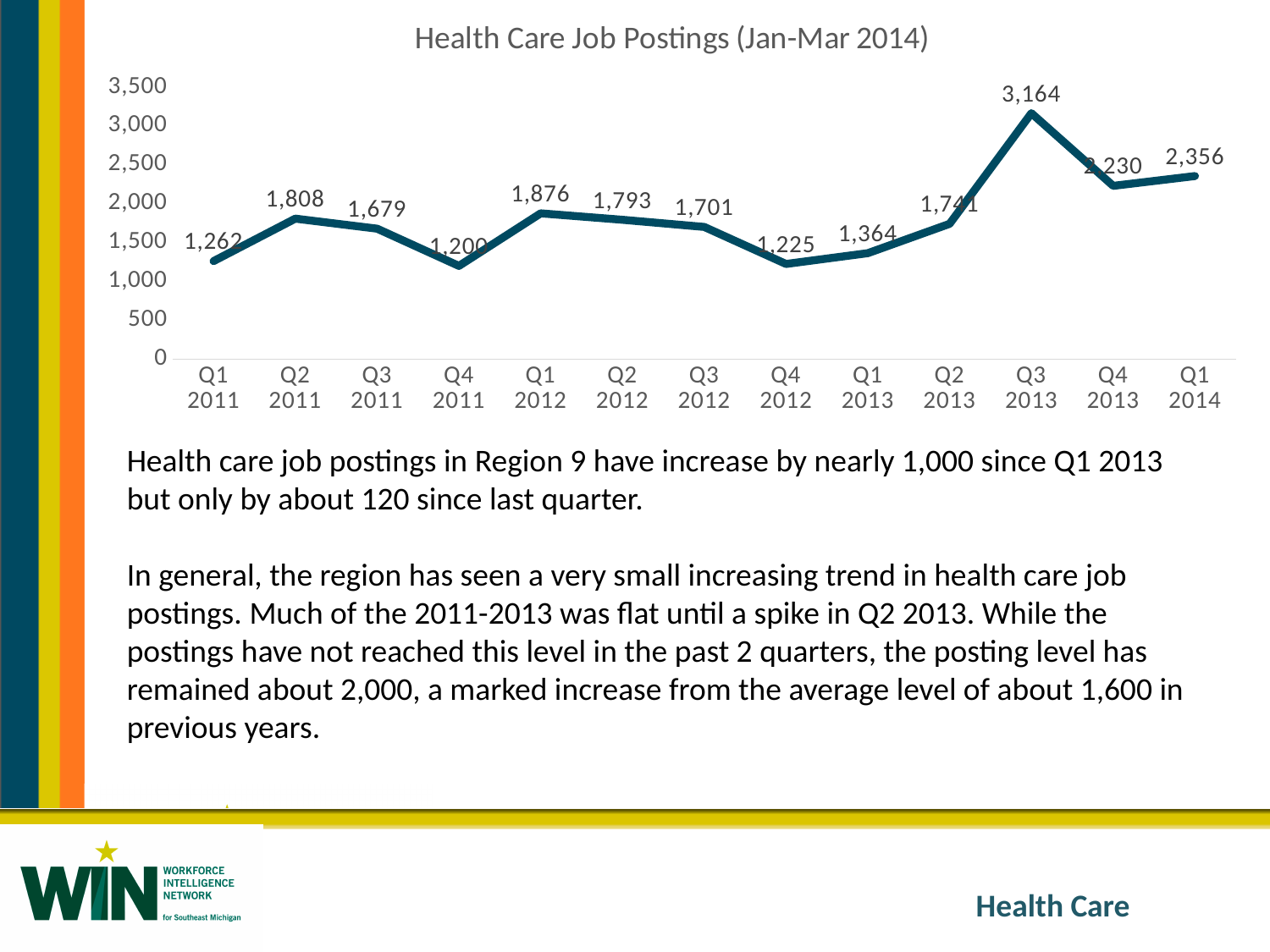
Is the value for Q3 2013 greater or less than 3,000? greater What is the title of the chart? Health Care Job Postings (Jan-Mar 2014) Which is larger, the value for Q2 2011 or the value for Q3 2011? Q2 2011 What is the value for Q1 2011? 1,262 What is the value for Q1 2012? 1,876 Which quarter has the highest number of health care job postings? Q3 2013 What is the value for Q1 2014? 2,356 What is the difference between the values for Q3 2013 and Q1 2014? 808 How many quarters are plotted on the chart? 13 What is the difference between the values for Q1 2014 and Q1 2013? 992 What kind of chart is shown on the slide? line chart What is the value for Q3 2013? 3,164